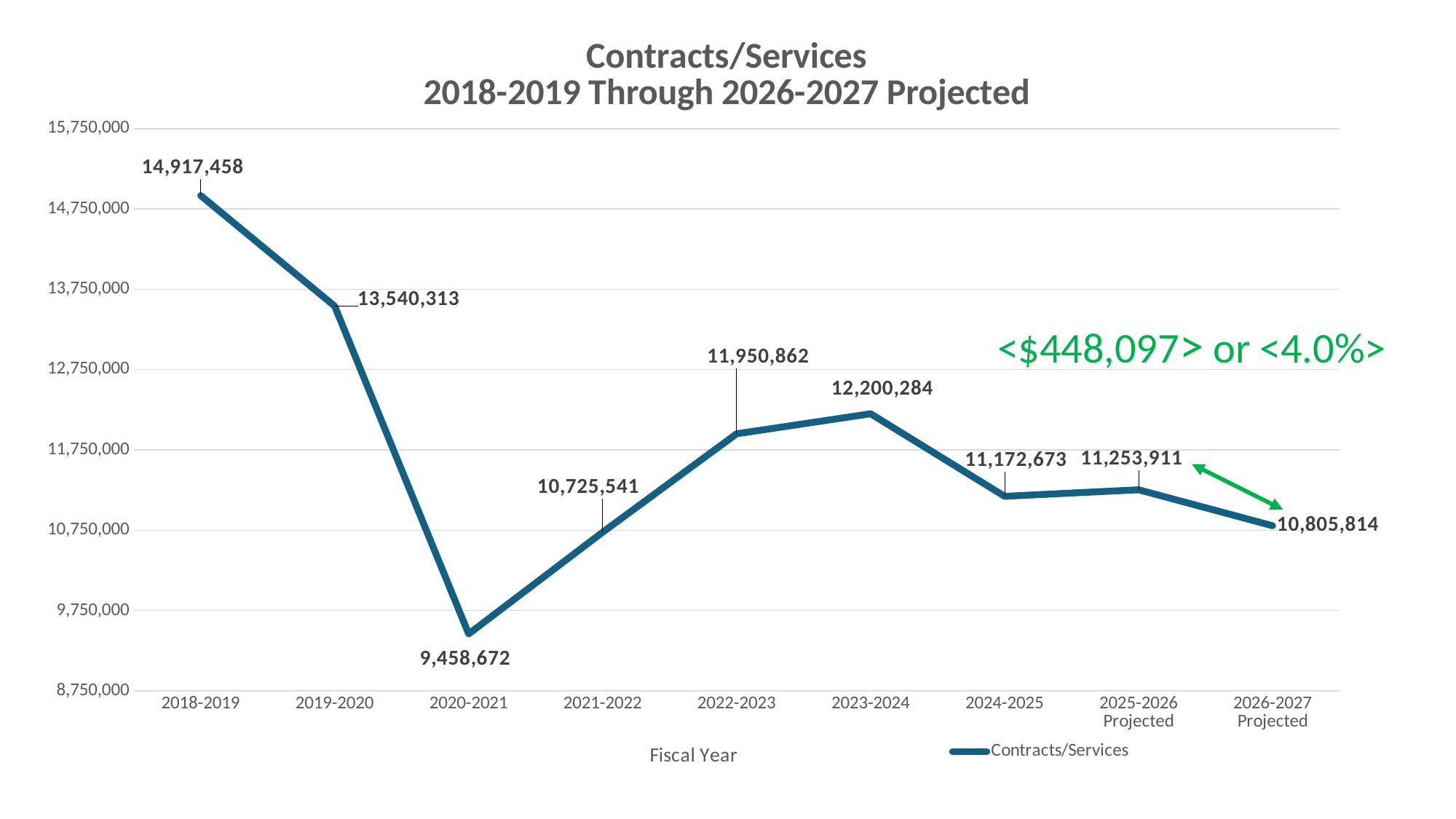
What is the difference between the 2018-2019 value and the 2019-2020 value? 1,377,145 Does the Contracts/Services value rise or fall from 2018-2019 to 2020-2021? Fall What is the Contracts/Services value for 2018-2019? 14,917,458 What is the projected Contracts/Services value for 2026-2027? 10,805,814 What is the difference between the 2025-2026 Projected value and the 2026-2027 Projected value? 448,097 Which is larger, the value for 2022-2023 or the value for 2024-2025? 2022-2023 What kind of chart is shown on the slide? Line chart Which fiscal year has the highest Contracts/Services value? 2018-2019 What is the Contracts/Services value for 2020-2021? 9,458,672 What is the Contracts/Services value for 2023-2024? 12,200,284 How many fiscal years are plotted on the chart? 9 Which fiscal year has the lowest Contracts/Services value? 2020-2021